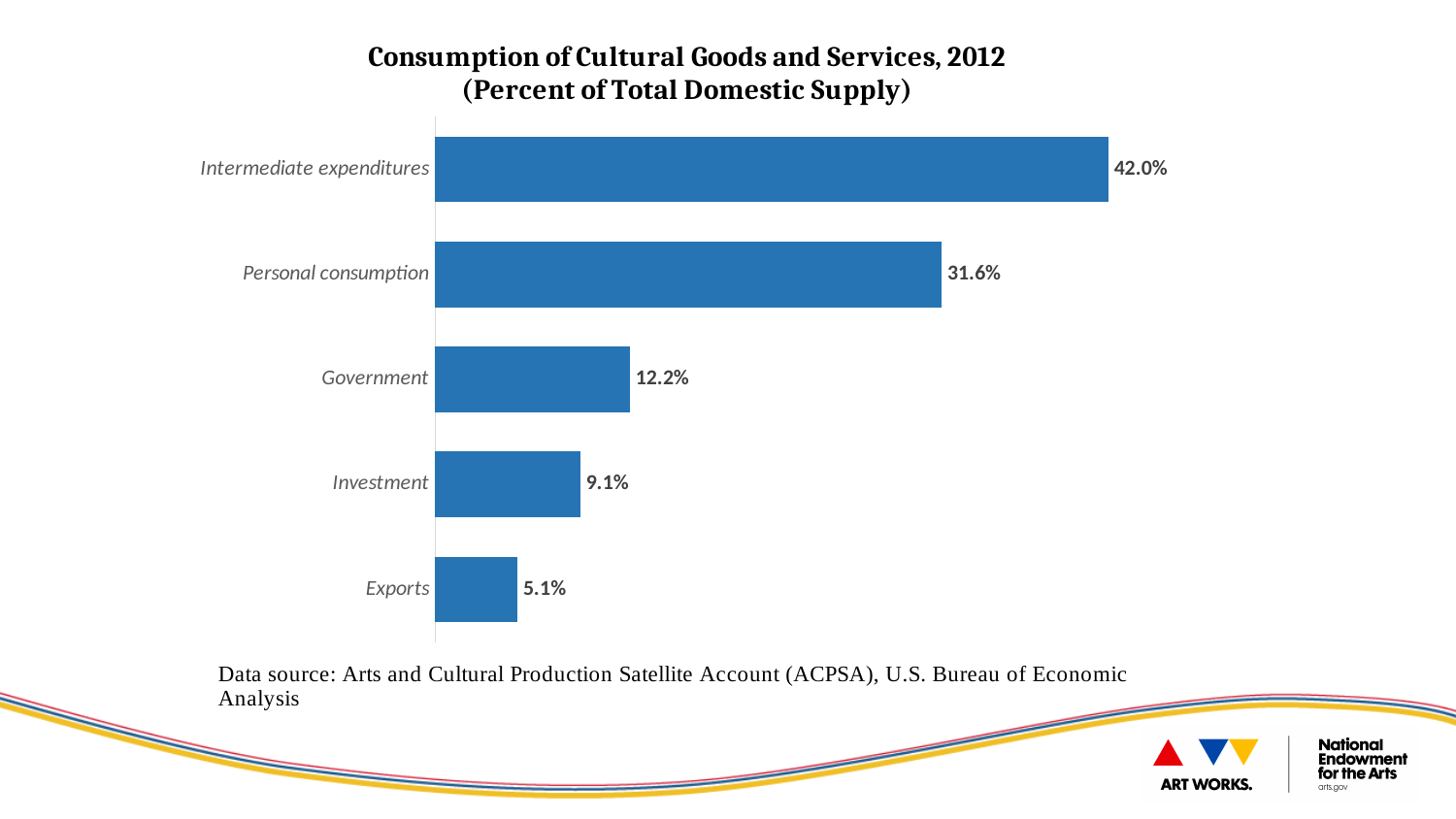
Which is larger, Investment or Exports? Investment What is the difference between Government and Investment? 3.1% Which category has the highest value? Intermediate expenditures What is the difference between Intermediate expenditures and Personal consumption? 10.4% How many categories are shown in the chart? 5 What is the value for Government? 12.2% What is the value for Exports? 5.1% What is the value for Intermediate expenditures? 42.0% What is the value for Personal consumption? 31.6% Which category has the lowest value? Exports What kind of chart is this? Bar chart What is the title of the chart? Consumption of Cultural Goods and Services, 2012 (Percent of Total Domestic Supply)